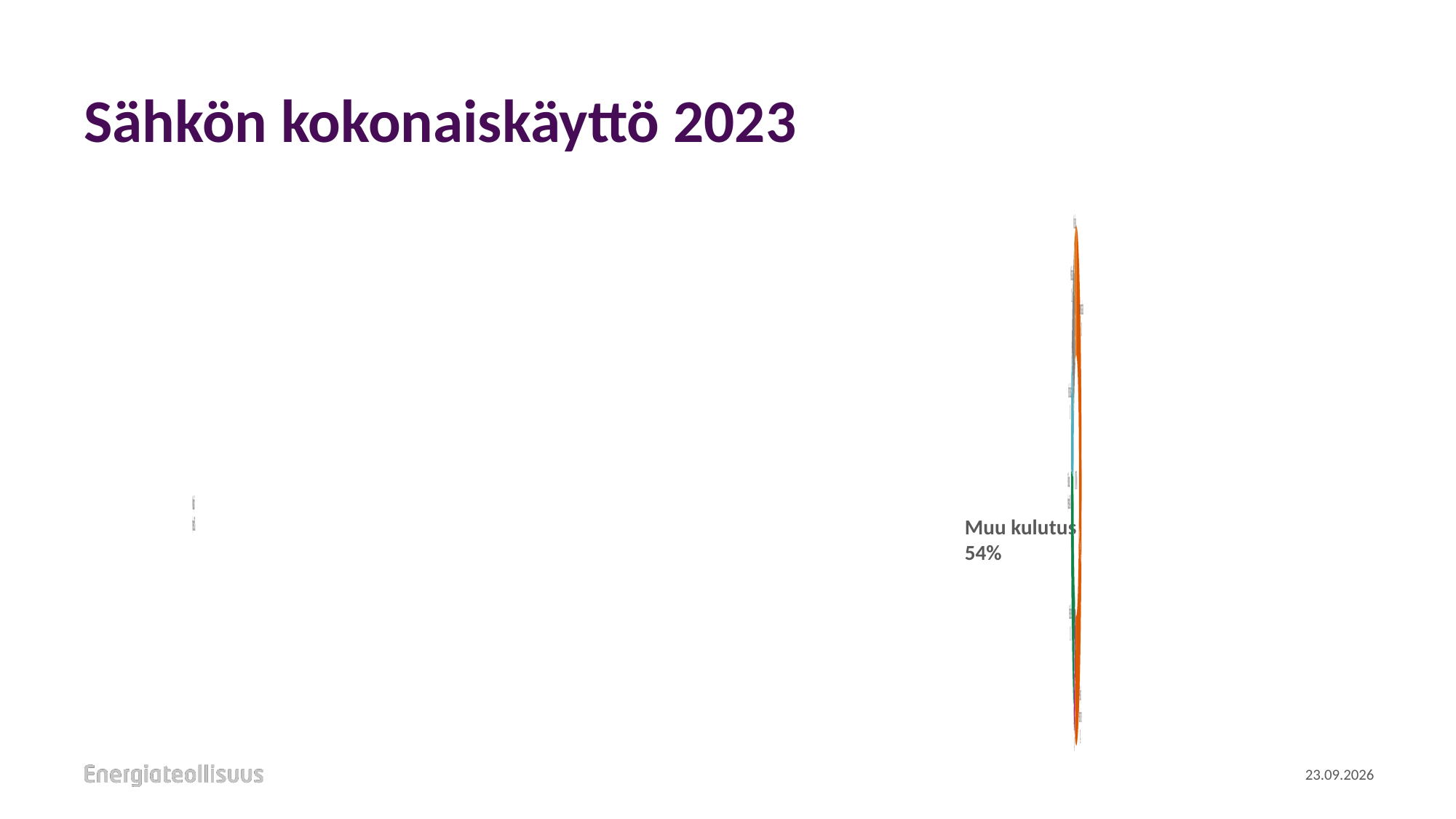
Is the share for "Muu kulutus" greater or less than 50%? greater What share of the chart does the slice labelled "Muu kulutus" represent? 54% What is the title of the slide containing the chart? Sähkön kokonaiskäyttö 2023 Which category is labelled with 54% on the chart? Muu kulutus